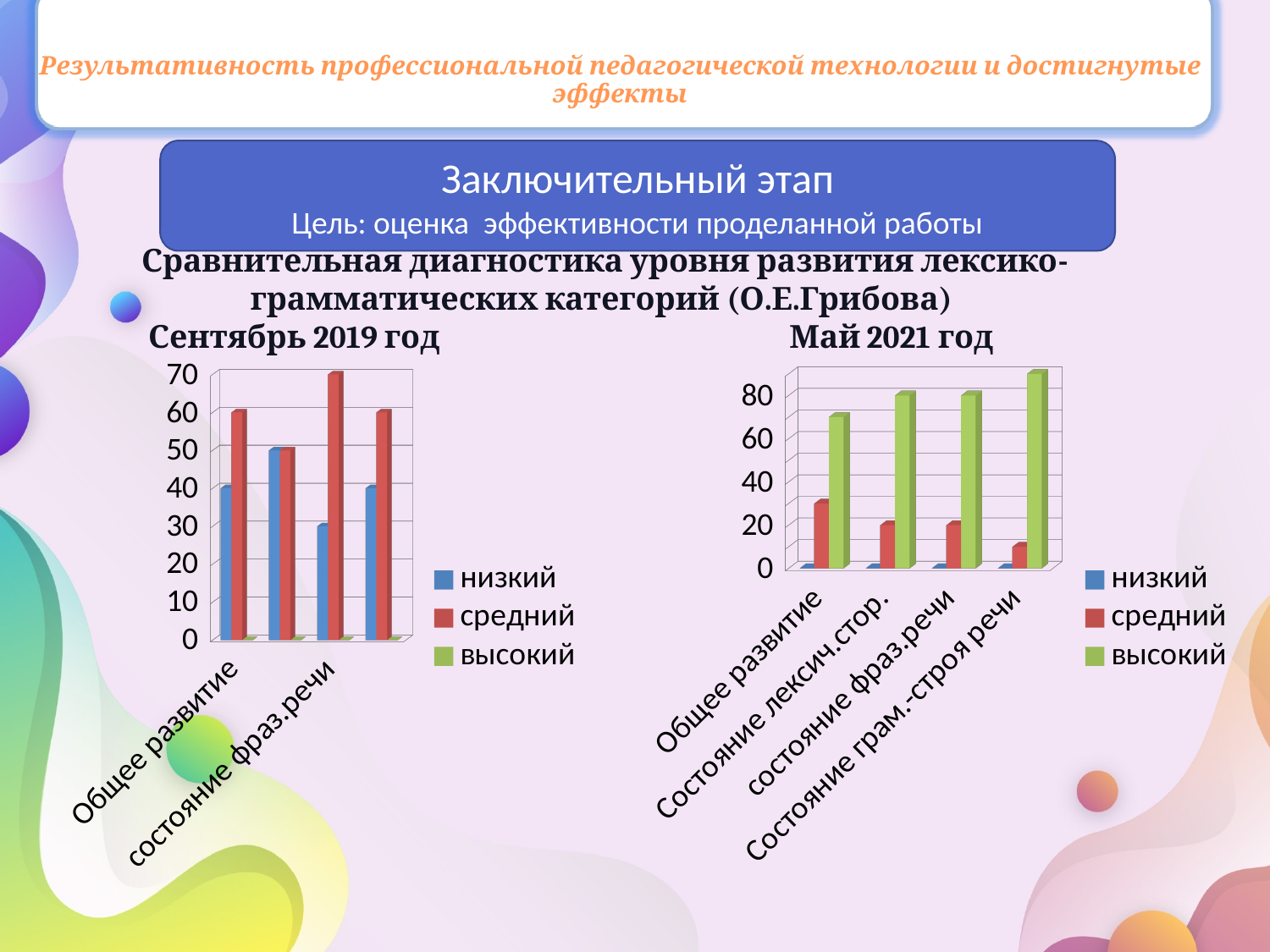
How many series does the legend of the 'Май 2021 год' chart list? 3 In the 'Май 2021 год' chart, which category has the highest value for 'высокий'? Состояние грам.-строя речи In the 'Сентябрь 2019 год' chart, which series is larger for 'Общее развитие': 'низкий' or 'средний'? средний In the 'Май 2021 год' chart, is the 'средний' value for 'Общее развитие' greater or less than 20? greater In the 'Сентябрь 2019 год' chart, is the 'средний' value for 'Общее развитие' greater or less than 50? greater In the 'Май 2021 год' chart, which category has the lowest value for 'средний'? Состояние грам.-строя речи How many categories are shown on the x axis of the 'Май 2021 год' chart? 4 In the 'Май 2021 год' chart, is the 'высокий' value for 'Общее развитие' greater or less than 80? less What kind of chart is the 'Сентябрь 2019 год' chart? bar chart In the 'Май 2021 год' chart, which is larger for 'высокий': 'Общее развитие' or 'Состояние лексич.стор.'? Состояние лексич.стор. In the 'Май 2021 год' chart, what colour represents the 'высокий' series? green